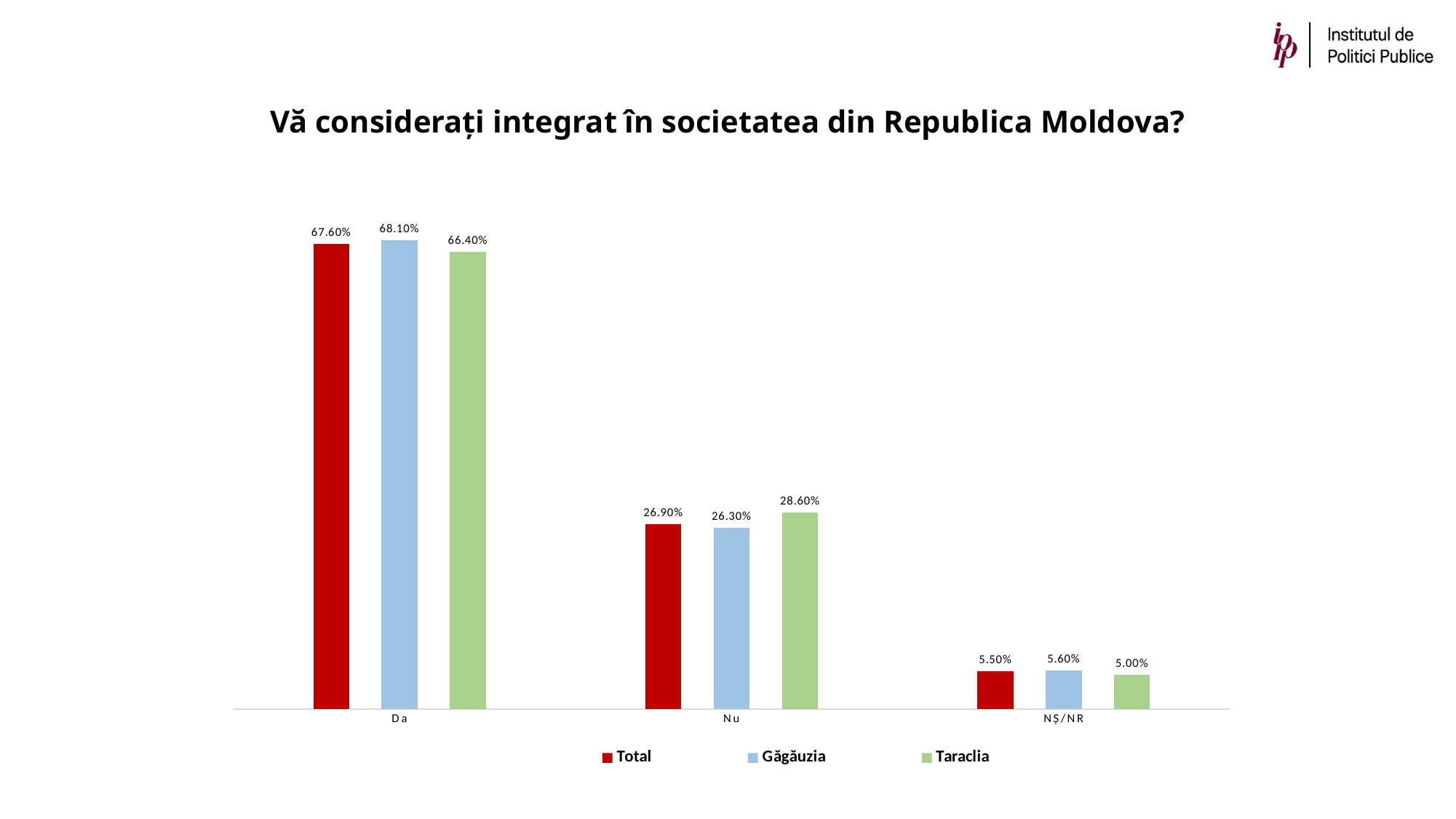
What is the value for Taraclia in the NȘ/NR category? 5.00% What is the title of the chart? Vă considerați integrat în societatea din Republica Moldova? In the Da category, which is larger: the Găgăuzia value or the Taraclia value? Găgăuzia What is the value for Taraclia in the Da category? 66.40% What is the value for Total in the Da category? 67.60% What is the value for Găgăuzia in the Nu category? 26.30% Which category has the lowest value for the Găgăuzia series? NȘ/NR How many categories are shown on the x axis? 3 What kind of chart is shown on the slide? Bar chart How many series does the legend list? 3 Which category has the highest value for the Total series? Da What is the difference between the Taraclia and Total values in the Nu category? 1.70%